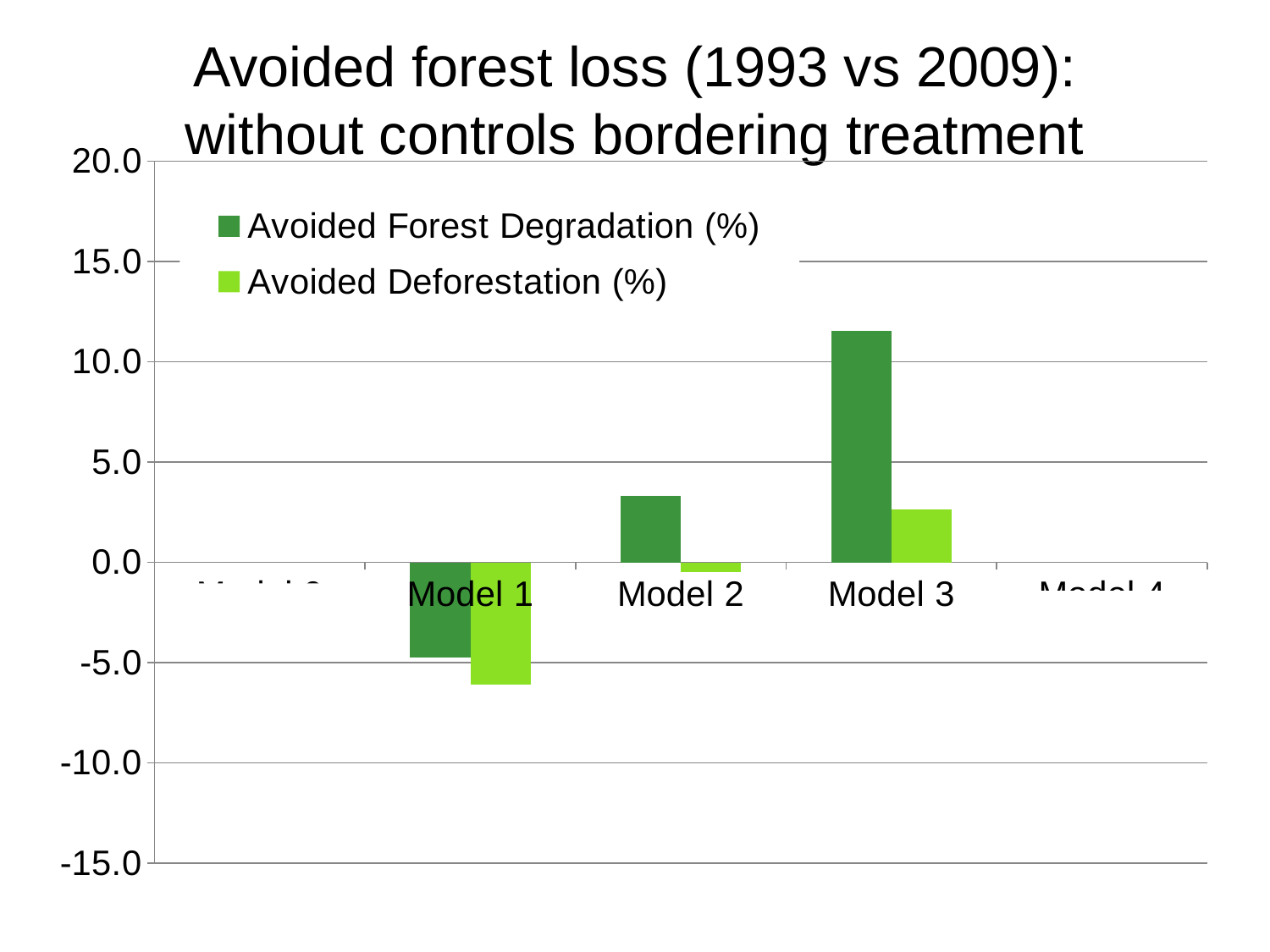
What are the two series named in the legend? Avoided Forest Degradation (%) and Avoided Deforestation (%) Among Model 1, Model 2 and Model 3, which has the highest Avoided Forest Degradation (%)? Model 3 What is the title of the chart? Avoided forest loss (1993 vs 2009): without controls bordering treatment What kind of chart is shown on the slide? Bar chart Is the Avoided Deforestation (%) value for Model 3 greater or less than 5.0? less Is the Avoided Forest Degradation (%) value for Model 3 greater or less than 10.0? greater Is the Avoided Deforestation (%) value for Model 1 greater or less than -5.0? less Does the Avoided Forest Degradation (%) value rise or fall from Model 1 to Model 3? rise Among Model 1, Model 2 and Model 3, which has the lowest Avoided Deforestation (%)? Model 1 How many series does the legend list? 2 Which is larger for Model 3: Avoided Forest Degradation (%) or Avoided Deforestation (%)? Avoided Forest Degradation (%)